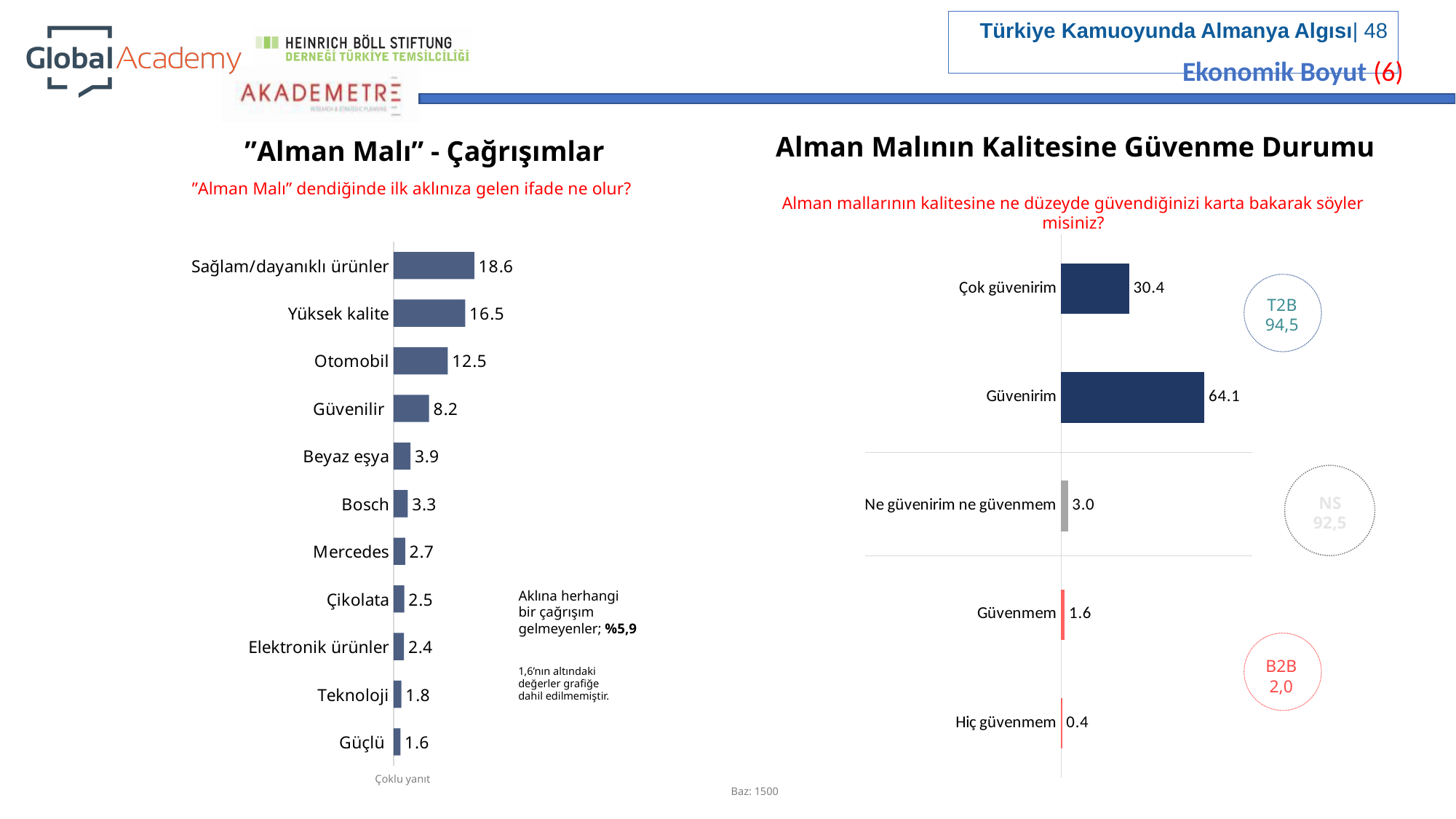
In the "Alman Malı" - Çağrışımlar chart, which category has the highest value? Sağlam/dayanıklı ürünler In the "Alman Malı" - Çağrışımlar chart, what is the value for Otomobil? 12.5 In the "Alman Malı" - Çağrışımlar chart, which is larger, Bosch or Mercedes? Bosch In the "Alman Malı" - Çağrışımlar chart, which category has the lowest value? Güçlü What kind of chart is the "Alman Malı" - Çağrışımlar chart? Bar chart In the Alman Malının Kalitesine Güvenme Durumu chart, what is the value for Güvenirim? 64.1 In the Alman Malının Kalitesine Güvenme Durumu chart, what is the difference between Güvenirim and Çok güvenirim? 33.7 In the Alman Malının Kalitesine Güvenme Durumu chart, what is the value for Hiç güvenmem? 0.4 In the "Alman Malı" - Çağrışımlar chart, how many categories are shown? 11 In the Alman Malının Kalitesine Güvenme Durumu chart, how many categories are shown? 5 In the "Alman Malı" - Çağrışımlar chart, what is the difference between Sağlam/dayanıklı ürünler and Yüksek kalite? 2.1 In the Alman Malının Kalitesine Güvenme Durumu chart, what value is shown in the T2B circle? 94,5